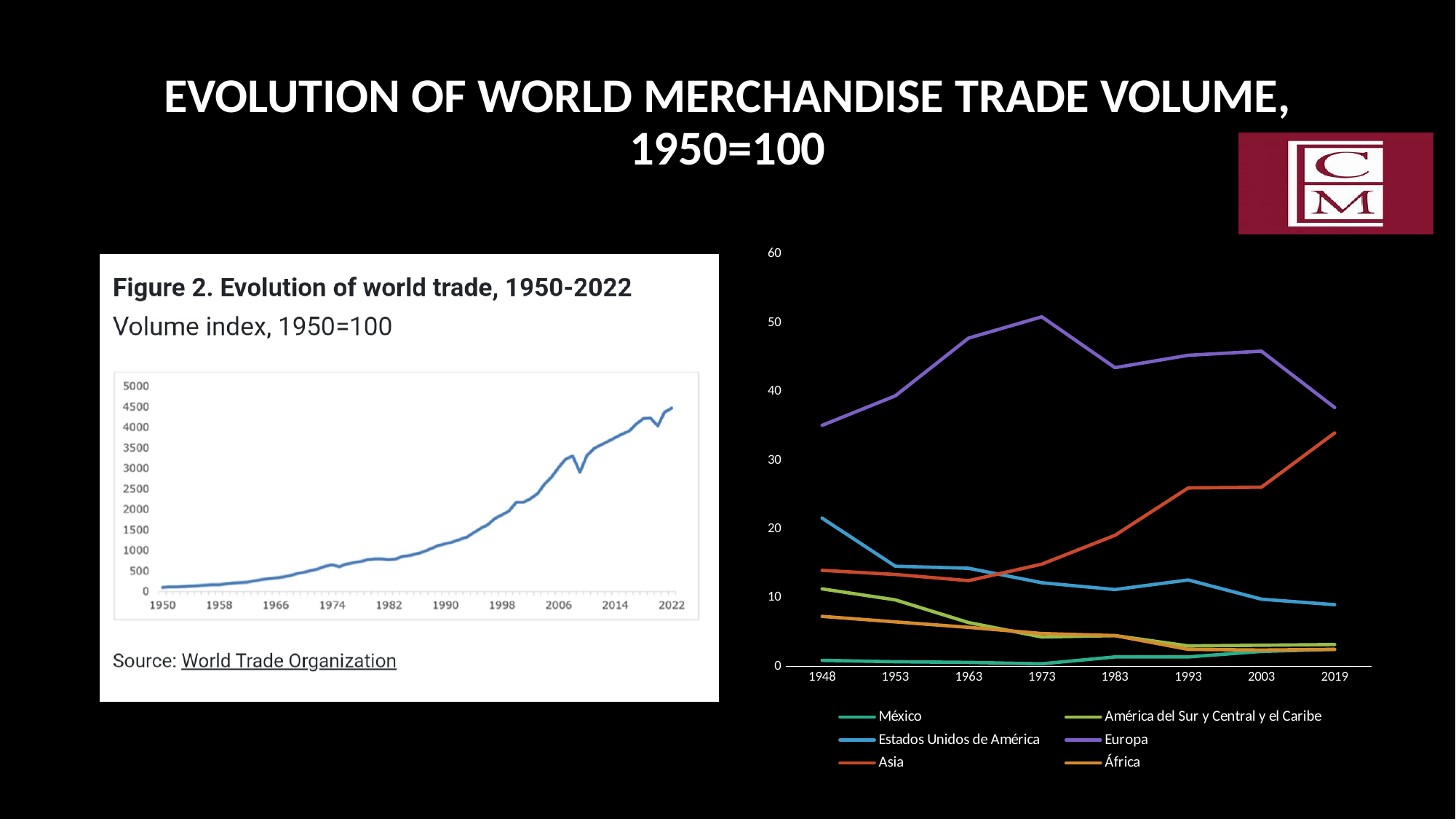
In the right-hand chart, which series has the highest value in 1973? Europa In the right-hand chart, which is larger in 2019: Asia or Estados Unidos de América? Asia In the left-hand chart (Figure 2), does the volume index rise or fall from 1950 to 2022? Rise How many series does the legend of the right-hand chart list? 6 How many years are shown on the x axis of the right-hand chart? 8 In the right-hand chart, is the value for Estados Unidos de América in 2019 greater or less than 10? less In the right-hand chart, does the Asia series rise or fall between 1983 and 2019? Rise What source is cited for the left-hand chart (Figure 2)? World Trade Organization What kind of chart is the chart on the right side of the slide? Line chart In the right-hand chart, which series has the lowest value in 1948? México In the right-hand chart, is the value for Europa in 1973 greater or less than 50? greater In the right-hand chart, is the value for Asia in 2019 greater or less than 30? greater